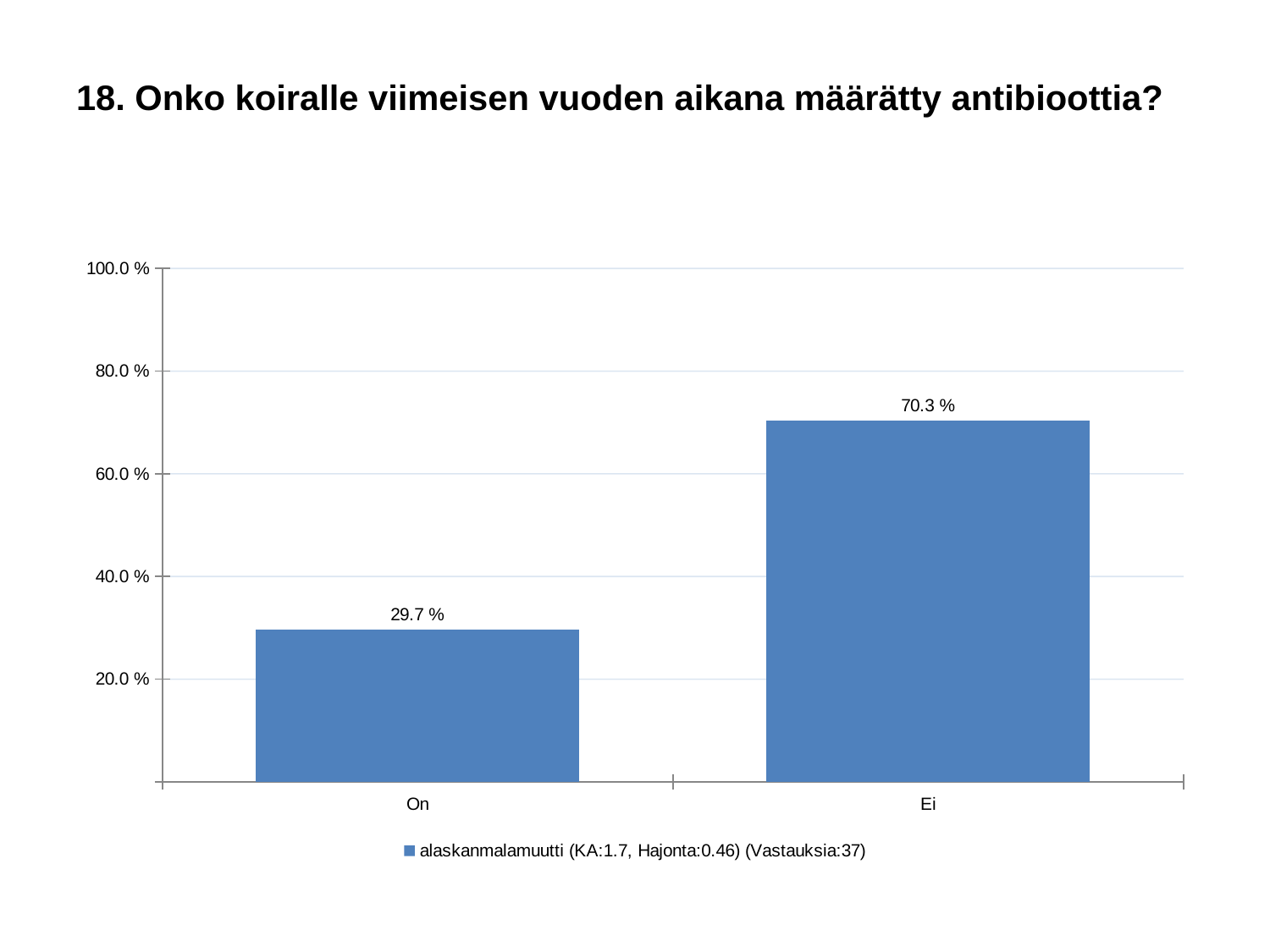
Is the value for "Ei" greater or less than 60.0 %? greater What is the value for "On"? 29.7 % How many responses (Vastauksia) does the legend entry report? 37 What is the value for "Ei"? 70.3 % How many series does the legend list? 1 What kind of chart is shown on the slide? bar chart What is the difference between the values for "Ei" and "On"? 40.6 % Which is larger, the value for "On" or the value for "Ei"? Ei Which category has the lowest value? On Is the value for "On" greater or less than 40.0 %? less How many categories are shown on the x axis? 2 Which category has the highest value? Ei